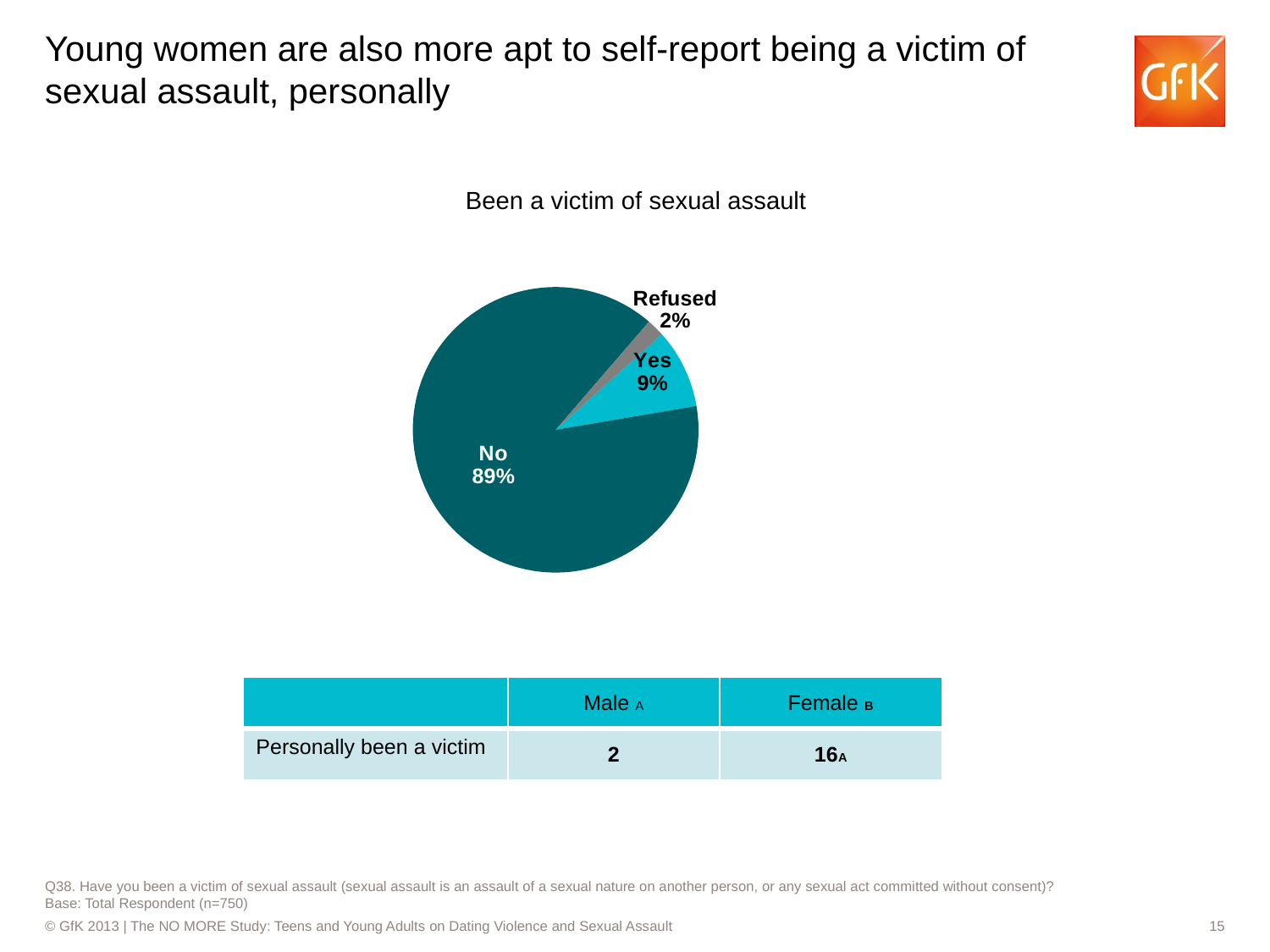
Which slice of the pie is the smallest? Refused Which slice of the pie is the largest? No What kind of chart is shown on the slide? pie chart What is the title of the chart? Been a victim of sexual assault What percentage of respondents answered "No"? 89% What share of the pie does the "Yes" slice represent? 9% What percentage of respondents refused to answer? 2% What is the combined percentage of the "Yes" and "Refused" slices? 11% What percentage of respondents answered "Yes"? 9% How many slices does the pie chart have? 3 What is the difference in percentage points between the "No" and "Yes" slices? 80 Which is larger, the "Yes" slice or the "Refused" slice? Yes